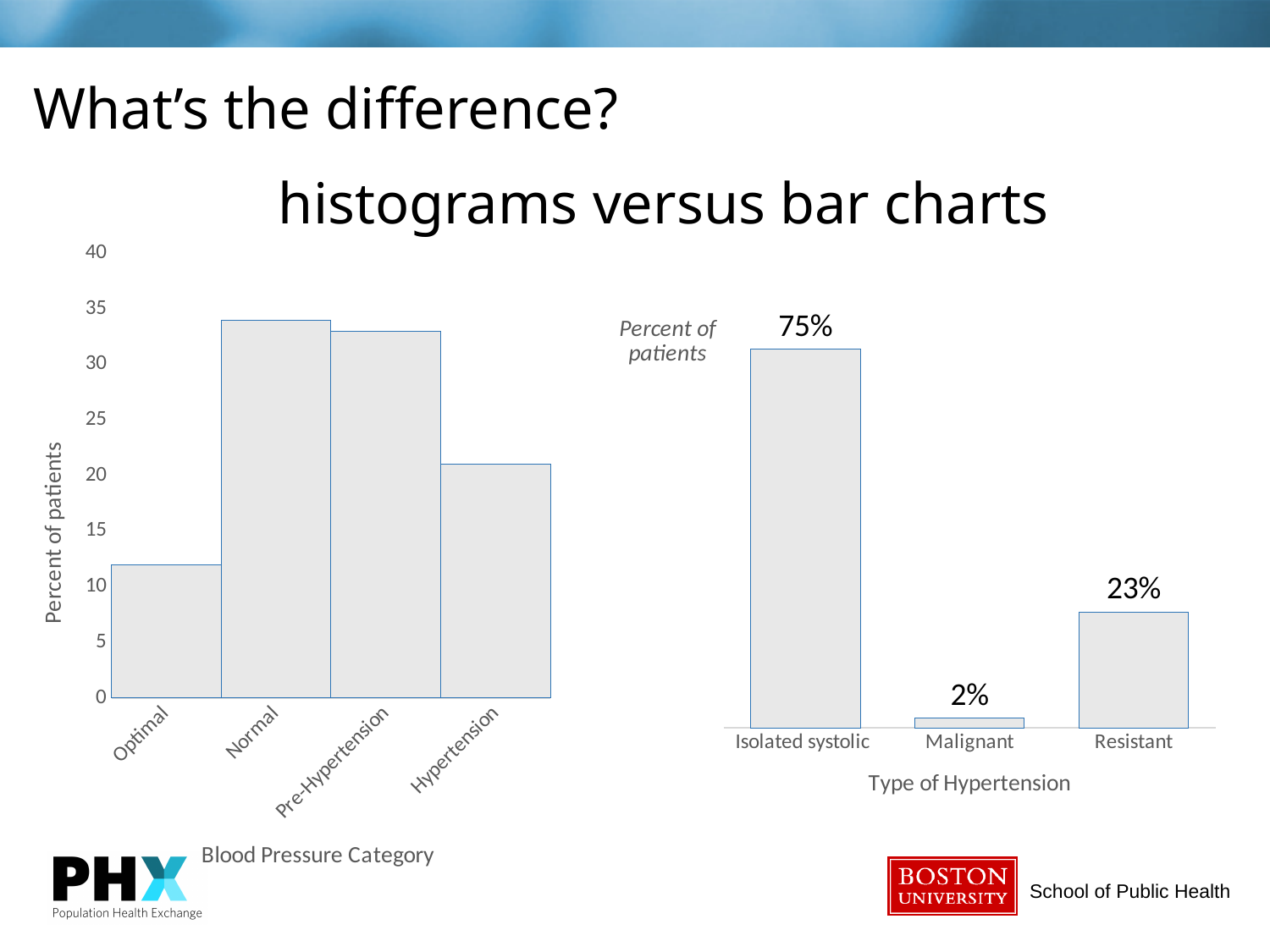
In the left-hand chart (Blood Pressure Category), is the value for Optimal greater or less than 15? less What is the label on the y axis of the left-hand chart? Percent of patients In the right-hand chart (Type of Hypertension), what is the value for Malignant? 2% In the left-hand chart (Blood Pressure Category), which category has the lowest percent of patients? Optimal In the right-hand chart (Type of Hypertension), what is the difference between the Isolated systolic and Resistant values? 52% In the right-hand chart (Type of Hypertension), how many types of hypertension are shown? 3 In the right-hand chart (Type of Hypertension), what percent of patients have isolated systolic hypertension? 75% In the right-hand chart (Type of Hypertension), what is the value for Resistant? 23% In the right-hand chart (Type of Hypertension), which type of hypertension has the lowest percent of patients? Malignant In the right-hand chart (Type of Hypertension), which type of hypertension has the highest percent of patients? Isolated systolic In the left-hand chart (Blood Pressure Category), is the value for Hypertension greater or less than 15? greater In the left-hand chart (Blood Pressure Category), how many blood pressure categories are shown on the x axis? 4